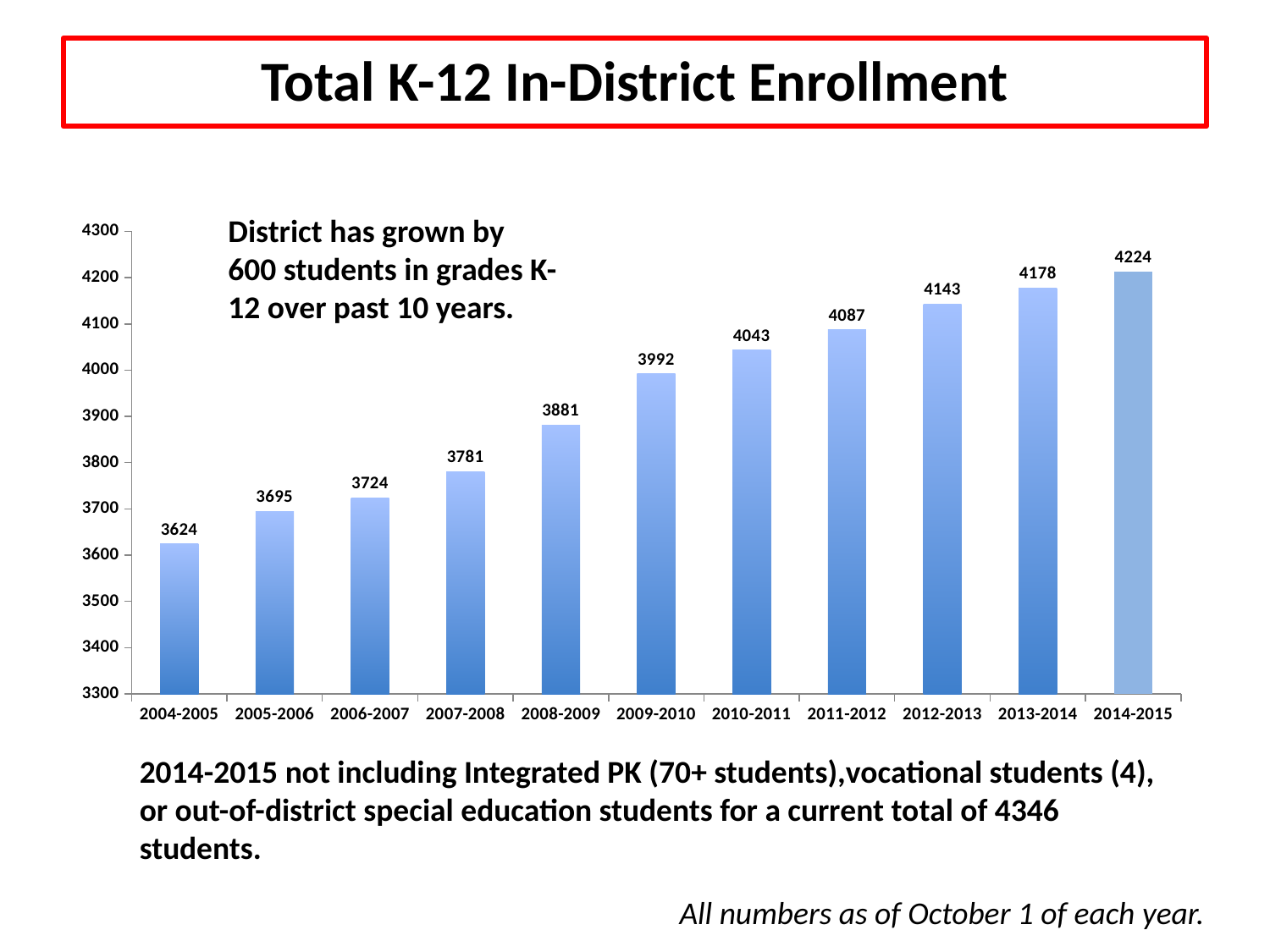
How many school years are shown on the chart? 11 Do enrollment values rise or fall from 2004-2005 to 2014-2015? Rise What is the enrollment value for 2014-2015? 4224 Which school year has the highest enrollment? 2014-2015 Which is larger, the enrollment for 2011-2012 or for 2010-2011? 2011-2012 Which school year has the lowest enrollment? 2004-2005 What is the difference in enrollment between 2008-2009 and 2007-2008? 100 What is the enrollment value for 2009-2010? 3992 What is the difference in enrollment between 2014-2015 and 2004-2005? 600 What kind of chart is shown on the slide? Bar chart What is the enrollment value for 2004-2005? 3624 Is the enrollment for 2012-2013 greater or less than 4100? greater